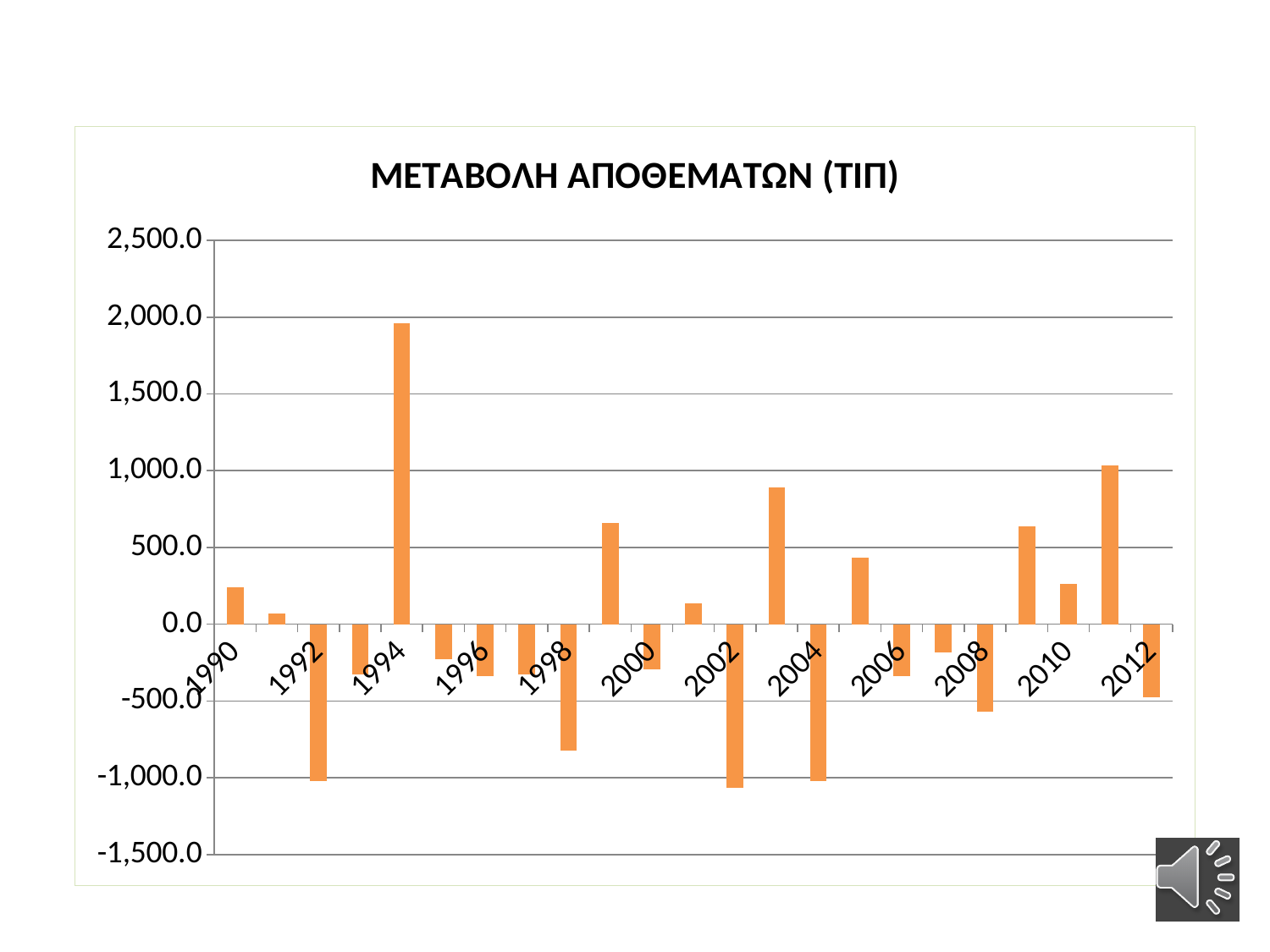
Which year has the highest value in the chart? 1994 Is the value for 1998 greater or less than -500.0? less Which year has the larger value, 1999 or 2003? 2003 Is the value for 1994 greater or less than 1,500.0? greater How many years (bars) are plotted in the chart? 23 What is the title of the chart? ΜΕΤΑΒΟΛΗ ΑΠΟΘΕΜΑΤΩΝ (ΤΙΠ) Is the value for 1999 greater or less than 500.0? greater Which year has the larger value, 1994 or 2011? 1994 What kind of chart is shown on the slide? bar chart What colour are the bars in the chart? orange